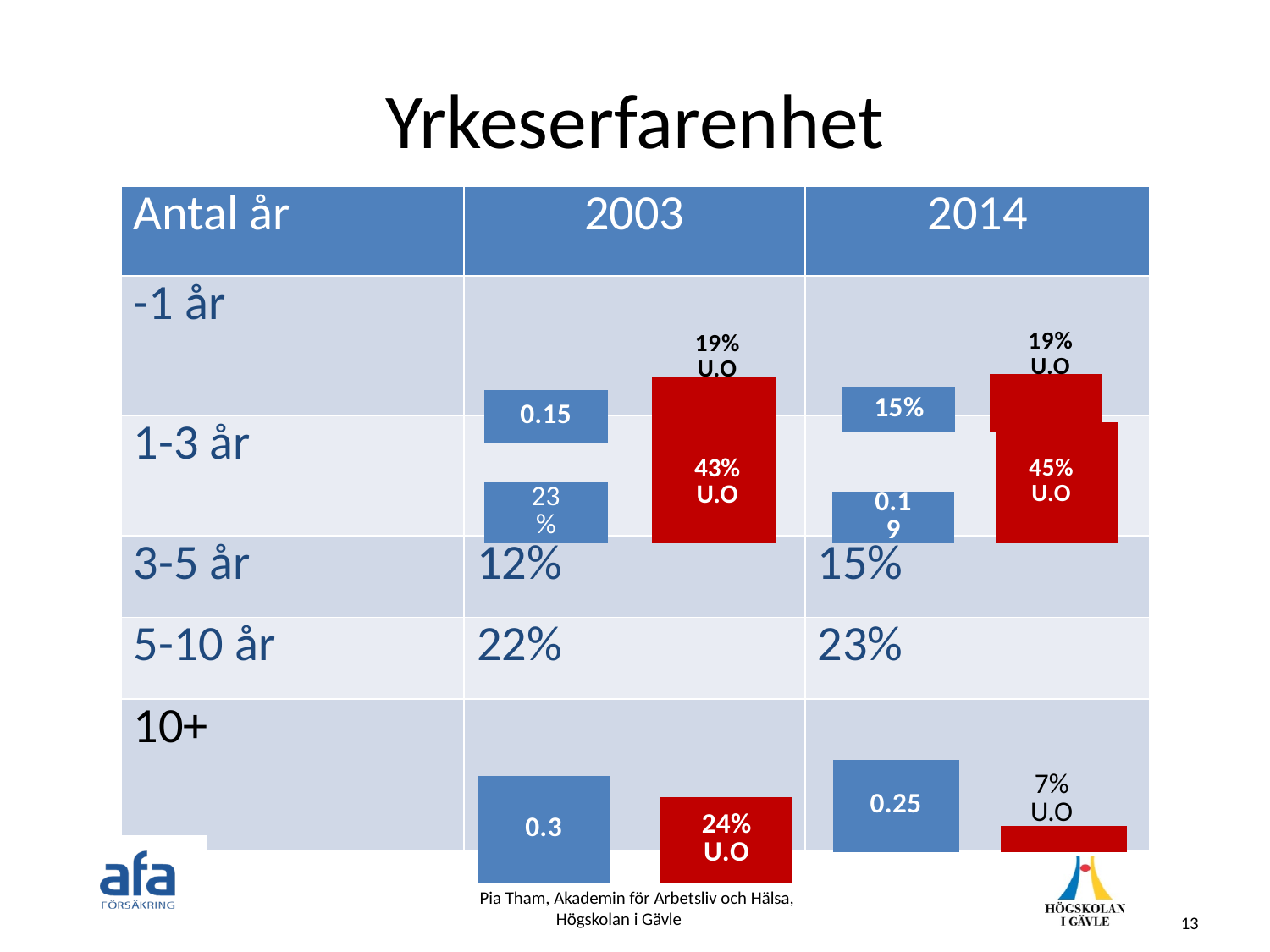
Which is larger, the red U.O bar in the '10+' row for 2003 or for 2014? 2003 How many year-range categories (rows) are listed under 'Antal år'? 5 What value is printed on the blue bar for '10+' in the 2003 column? 0.3 What value is printed on the blue bar for '10+' in the 2014 column? 0.25 What value is printed on the large red U.O bar in the 2003 column? 43% U.O What value is printed on the large red U.O bar in the 2014 column? 45% U.O What value is printed on the blue bar for '1-3 år' in the 2003 column? 23% What value is printed on the red U.O bar in the '10+' row for 2014? 7% U.O What value is printed on the blue bar for '-1 år' in the 2003 column? 0.15 What value is printed on the red U.O bar in the '10+' row for 2003? 24% U.O What value is printed on the blue bar for '-1 år' in the 2014 column? 15% What is the title of the slide containing the chart? Yrkeserfarenhet